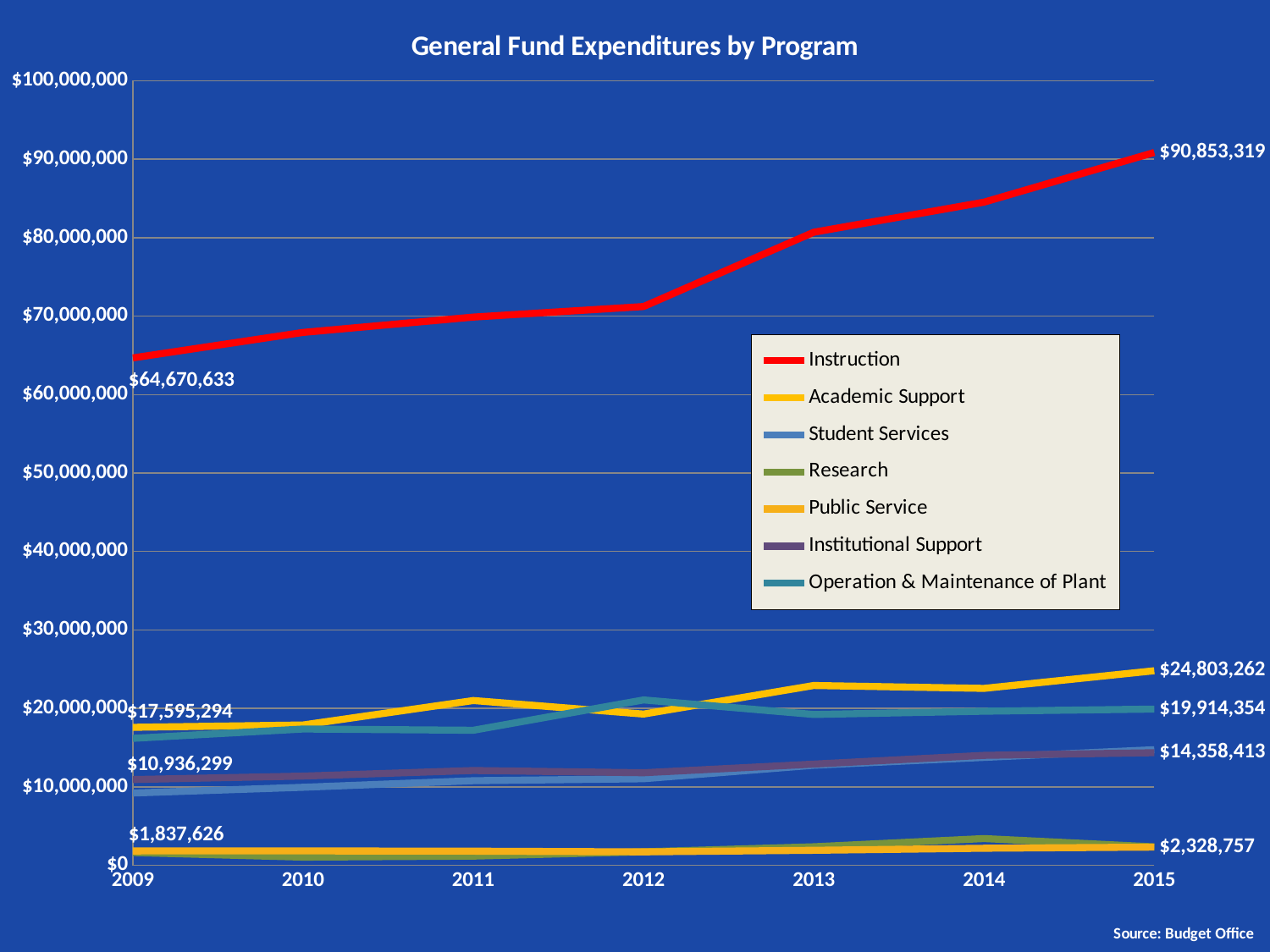
Is the Instruction expenditure in 2014 greater or less than $80,000,000? greater In 2015, which was larger: Academic Support or Operation & Maintenance of Plant? Academic Support What was the Instruction expenditure in 2009? $64,670,633 By how much did Academic Support expenditure increase from 2009 to 2015? $7,207,968 Which program had the highest expenditure in 2015? Instruction What was the Instruction expenditure in 2015? $90,853,319 What kind of chart is shown on the slide? Line chart What was the Academic Support expenditure in 2015? $24,803,262 What was the Academic Support expenditure in 2009? $17,595,294 How many years are shown along the x axis? 7 By how much did Instruction expenditure increase from 2009 to 2015? $26,182,686 How many series does the legend list? 7